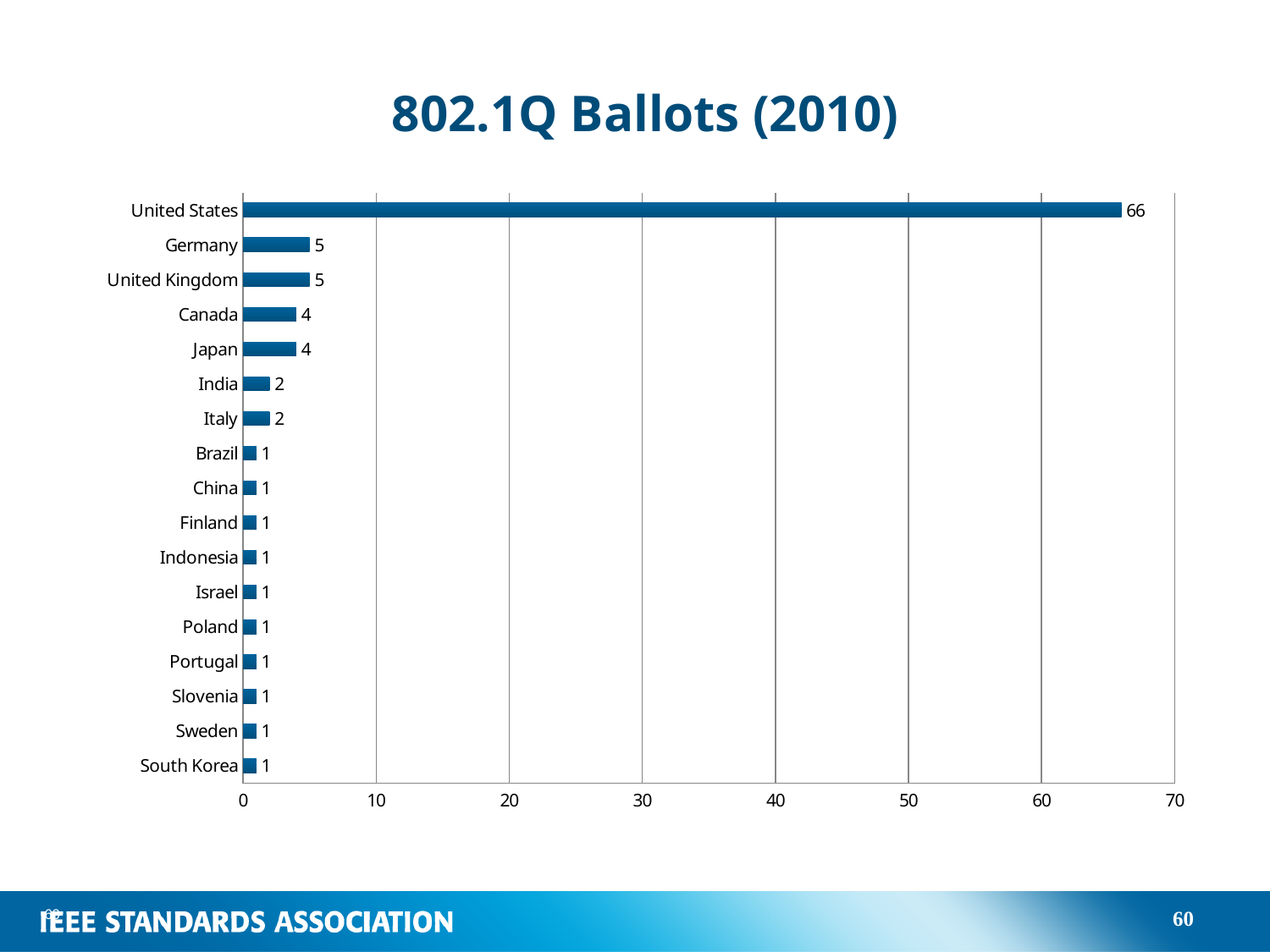
What is the value for Japan? 4 What is the title of the chart? 802.1Q Ballots (2010) What is the value for India? 2 What is the difference between the values for United States and Germany? 61 What is the value for Germany? 5 Which country has the highest value? United States What kind of chart is shown on the slide? bar chart Which is larger, the value for United Kingdom or the value for Brazil? United Kingdom Is the value for United States greater or less than 60? greater What is the value for United States? 66 How many countries are shown in the chart? 17 What is the difference between the values for Canada and Italy? 2